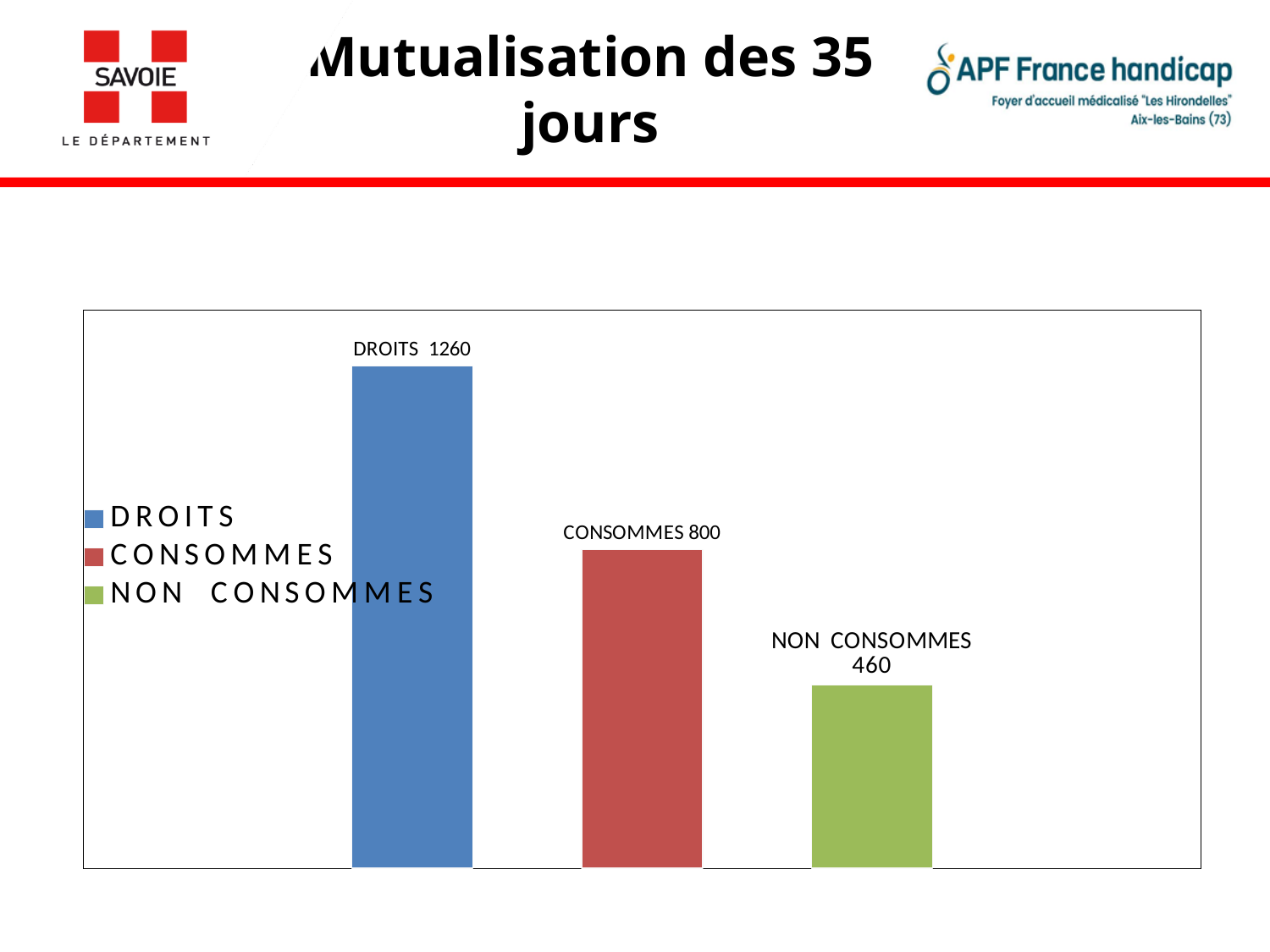
Which category has the lowest value? NON CONSOMMES What is the difference between CONSOMMES and NON CONSOMMES? 340 What is the value for DROITS? 1260 How many bars are shown in the chart? 3 What is the value for CONSOMMES? 800 Which is larger, CONSOMMES or NON CONSOMMES? CONSOMMES What is the value for NON CONSOMMES? 460 What kind of chart is shown on the slide? Bar chart What is the difference between DROITS and CONSOMMES? 460 How many entries does the legend list? 3 What colour is the bar for NON CONSOMMES? Green Which category has the highest value? DROITS